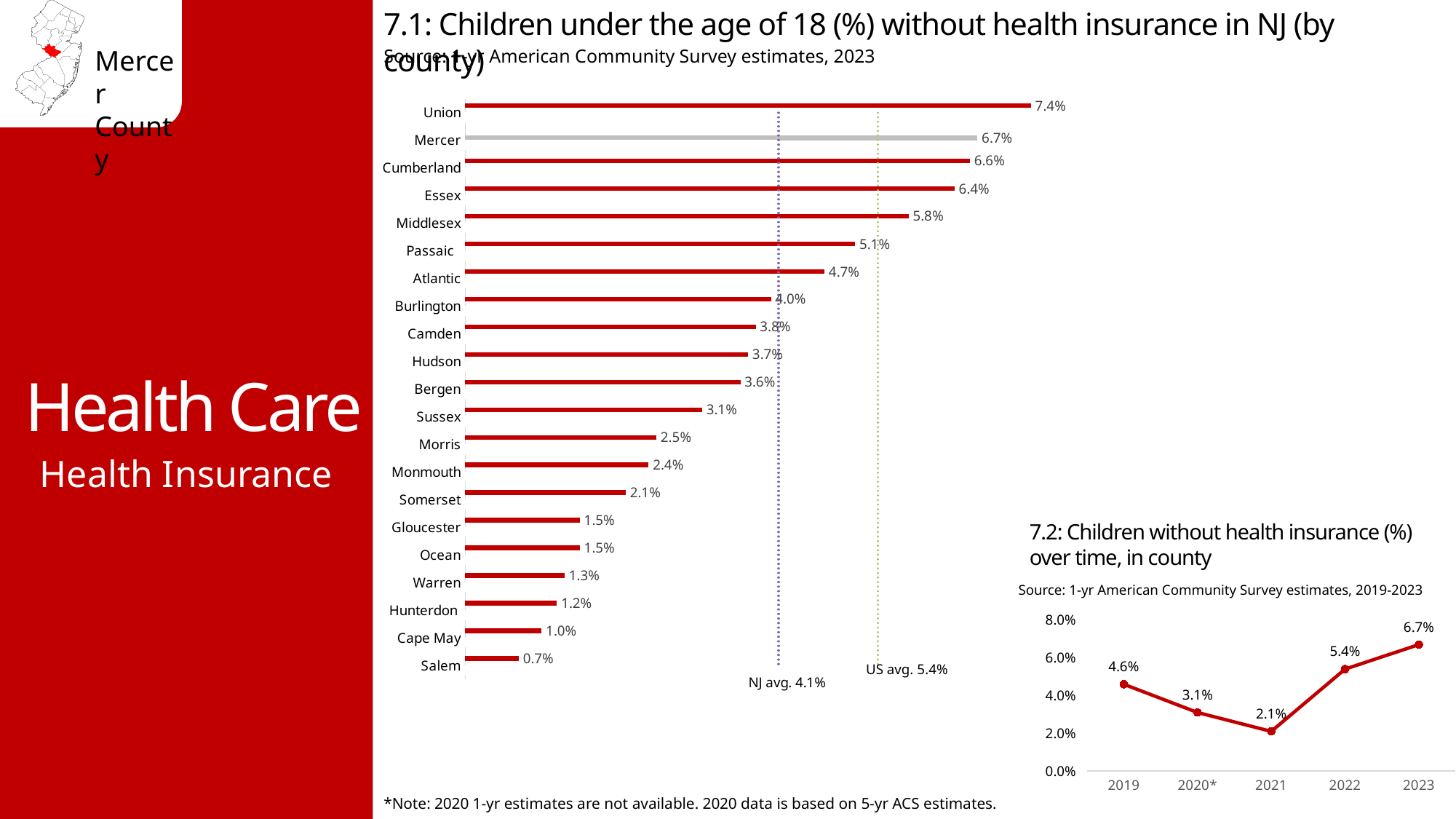
In chart 7.2 (over time), what is the difference between the 2023 and 2022 values? 1.3% In chart 7.1 (by county), which has a higher value, Passaic or Atlantic? Passaic In chart 7.1 (by county), which county has the highest percentage of children without health insurance? Union In chart 7.1 (by county), how many counties are shown? 21 In chart 7.1 (children under 18 without health insurance by county), what is the value for Mercer? 6.7% In chart 7.2 (over time), which year has the highest value? 2023 In chart 7.2 (children without health insurance over time), what is the value for 2021? 2.1% In chart 7.1 (by county), what is the NJ average shown by the dotted reference line? 4.1% In chart 7.1 (by county), what is the difference between the values for Union and Mercer? 0.7% What kind of chart is chart 7.2 (children without health insurance over time)? Line chart In chart 7.1 (by county), which county has the lowest percentage of children without health insurance? Salem What kind of chart is chart 7.1 (children without health insurance by county)? Bar chart